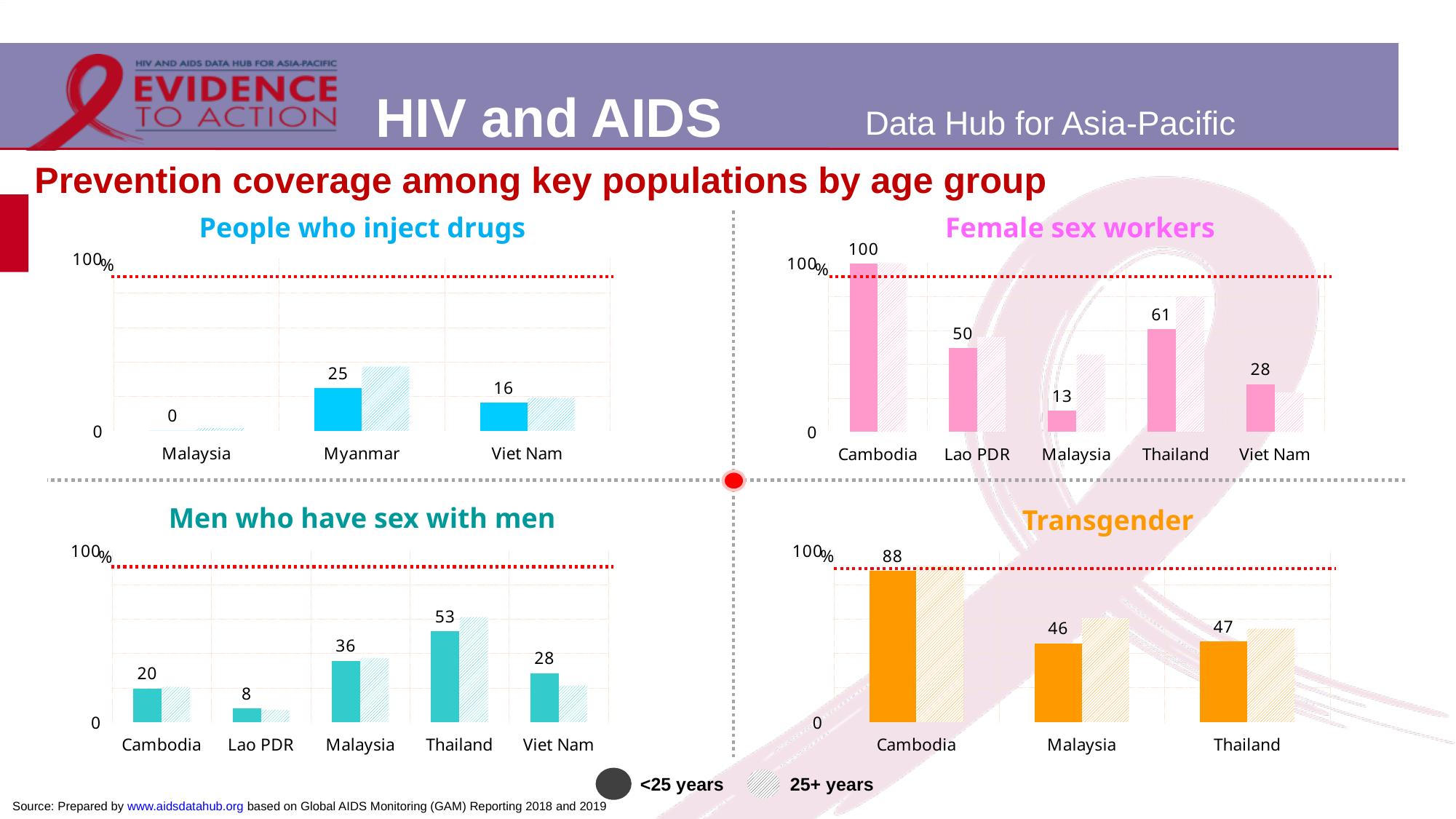
In the Men who have sex with men chart, what is the value for Lao PDR among those under 25 years? 8 How many countries are shown in the Transgender chart? 3 How many countries are shown in the Female sex workers chart? 5 In the Female sex workers chart, what is the difference between the under 25 years values for Lao PDR and Malaysia? 37 In the Men who have sex with men chart, which is larger for the under 25 years group: Malaysia or Viet Nam? Malaysia In the Female sex workers chart, which country has the highest value for the under 25 years group? Cambodia What type of chart is the People who inject drugs chart? Bar chart In the Female sex workers chart, what is the value for Thailand among those under 25 years? 61 In the Transgender chart, what is the value for Cambodia among those under 25 years? 88 In the Men who have sex with men chart, which country has the lowest value for the under 25 years group? Lao PDR How many series does the legend at the bottom of the slide list? 2 In the People who inject drugs chart, what is the value for Myanmar among those under 25 years? 25